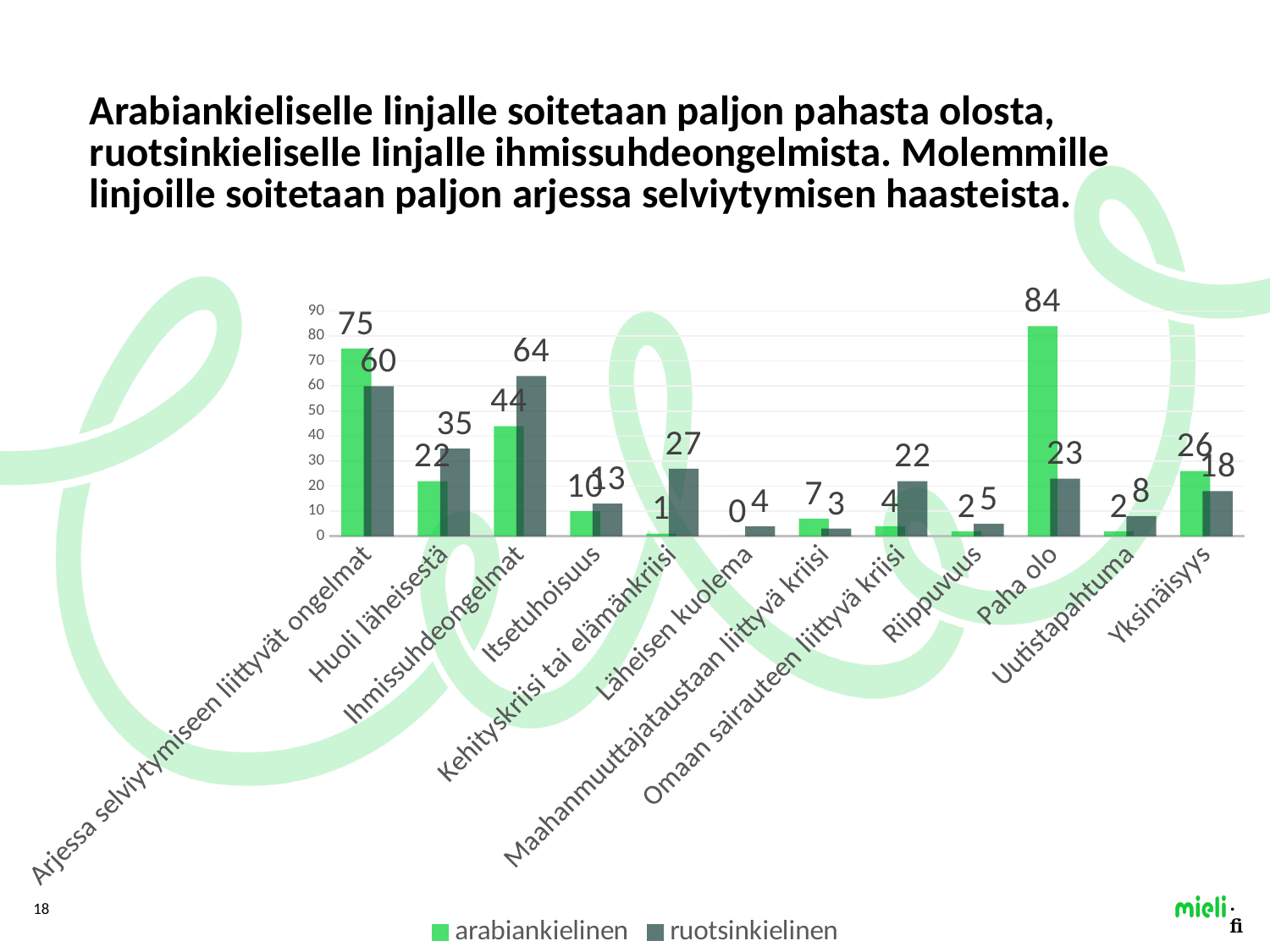
What kind of chart is shown on the slide? bar chart What is the value for arabiankielinen in the Paha olo category? 84 Which category has the highest value for the ruotsinkielinen series? Ihmissuhdeongelmat What is the difference between the arabiankielinen and ruotsinkielinen values for Paha olo? 61 What is the value for ruotsinkielinen in the Kehityskriisi tai elämänkriisi category? 27 What is the value for ruotsinkielinen in the Ihmissuhdeongelmat category? 64 How many series does the legend list? 2 Which category has the highest value for the arabiankielinen series? Paha olo How many categories are shown on the x axis? 12 For Yksinäisyys, which series has the larger value, arabiankielinen or ruotsinkielinen? arabiankielinen What is the difference between the ruotsinkielinen and arabiankielinen values for Huoli läheisestä? 13 Which category has the lowest value for the arabiankielinen series? Läheisen kuolema